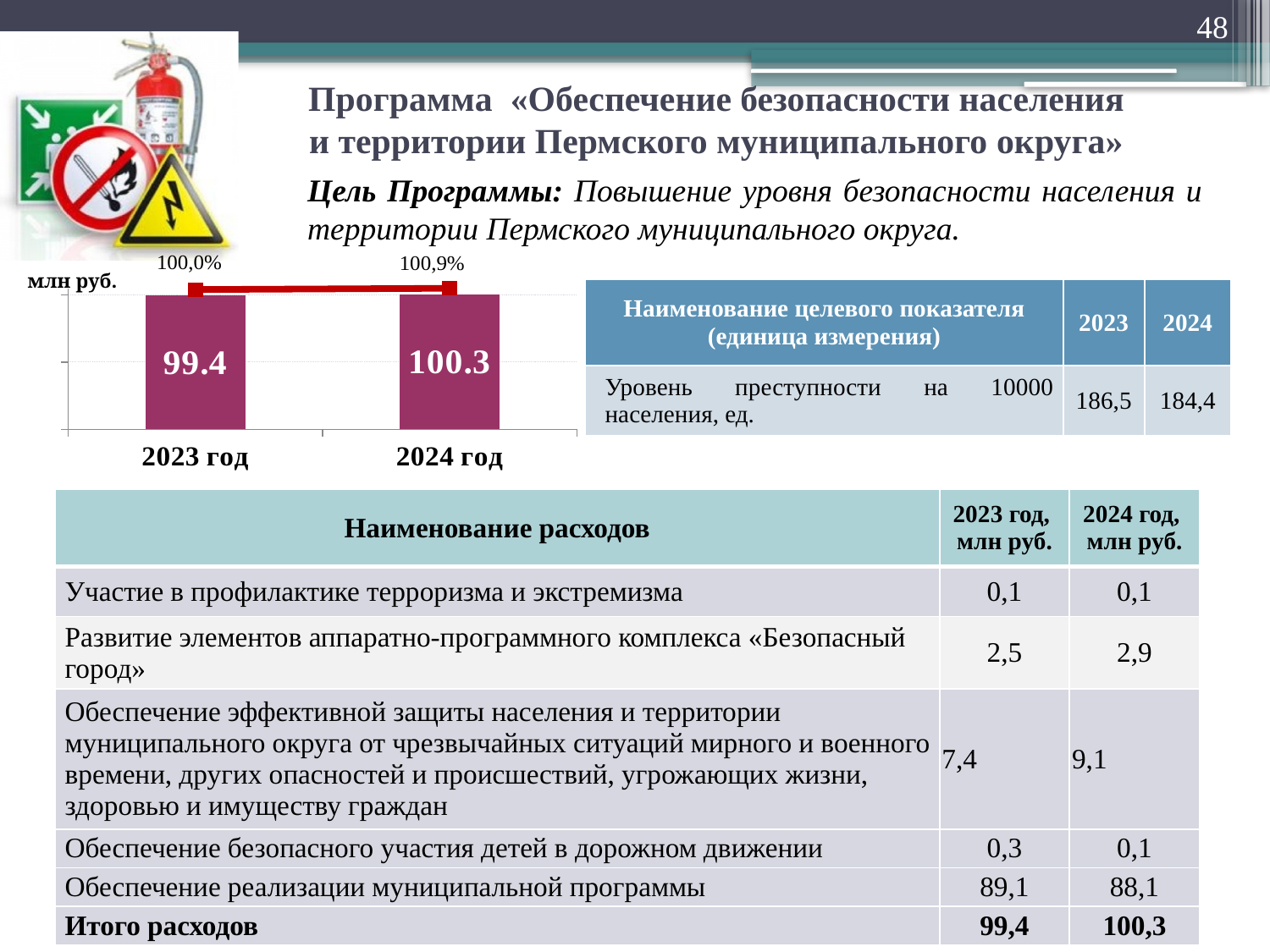
What unit of measurement is indicated on the chart's axis? млн руб. Which category has the highest bar in the chart? 2024 год What kind of chart is shown on the slide? combination bar and line chart What percentage label is shown above the 2023 год bar in the chart? 100,0% What percentage label is shown above the 2024 год bar in the chart? 100,9% What is the value of the bar for 2023 год in the chart? 99.4 How many bars are plotted in the chart? 2 Do the bar values rise or fall from 2023 год to 2024 год in the chart? rise What is the difference between the bar values for 2024 год and 2023 год in the chart? 0.9 Which year has the higher bar in the chart, 2023 год or 2024 год? 2024 год What is the value of the bar for 2024 год in the chart? 100.3 Which category has the lowest bar in the chart? 2023 год